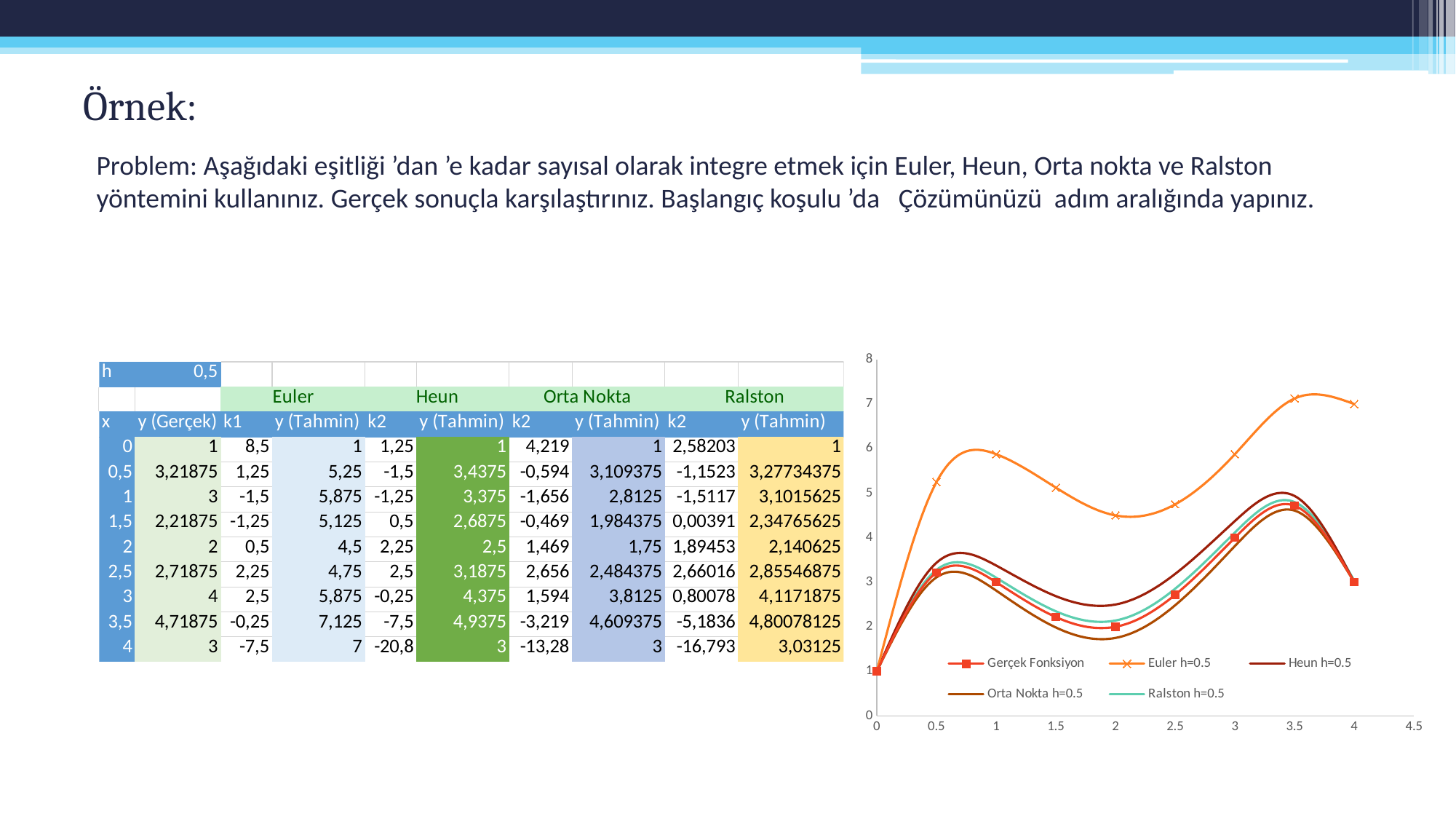
How many series does the chart legend list? 5 Which series reaches the highest value on the chart? Euler h=0.5 What colour is the Euler h=0.5 line in the chart? orange Does the Euler h=0.5 series rise or fall between x = 2 and x = 3.5? rise What is the value of Gerçek Fonksiyon at x = 0? 1 Is the value of Euler h=0.5 at x = 0.5 greater or less than 5? greater Is the value of Euler h=0.5 at x = 2 greater or less than 4? greater Is the value of Gerçek Fonksiyon at x = 2.5 greater or less than 3? less What is the value of Gerçek Fonksiyon at x = 3? 4 What kind of chart is shown on the slide? line chart At x = 0.5, which is larger: Euler h=0.5 or Gerçek Fonksiyon? Euler h=0.5 What is the value of Gerçek Fonksiyon at x = 4? 3